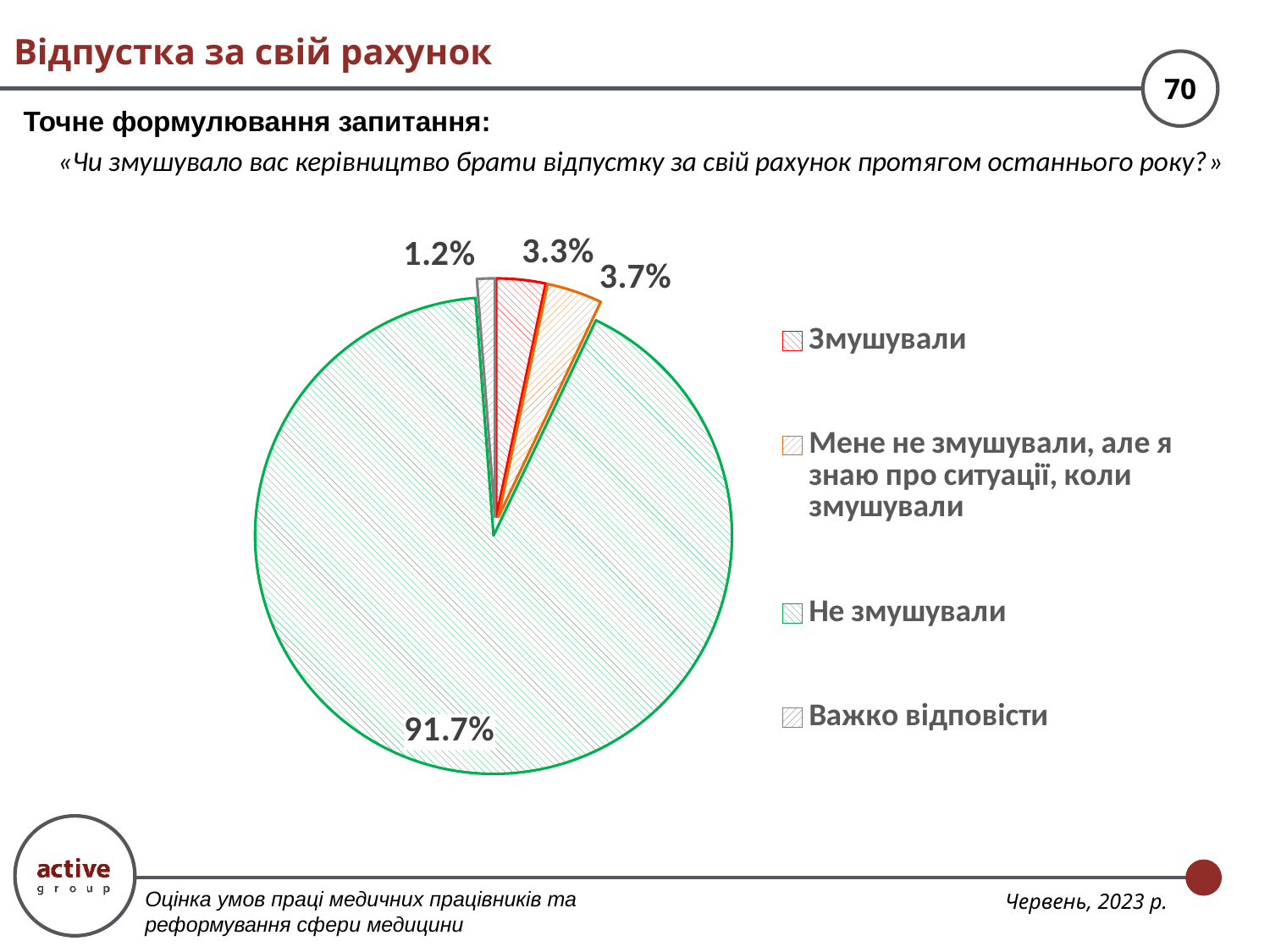
How many entries does the legend list? 4 What type of chart is shown on the slide? pie chart What percentage of respondents answered "Мене не змушували, але я знаю про ситуації, коли змушували"? 3.7% Which answer option has the largest share of the pie? Не змушували Which answer option has the smallest share of the pie? Важко відповісти What is the difference in percentage points between "Не змушували" and "Змушували"? 88.4 What colour is the slice for "Не змушували"? green What percentage of respondents answered "Змушували"? 3.3% Which is larger: the share for "Змушували" or the share for "Важко відповісти"? Змушували How many slices does the pie chart have? 4 What percentage of respondents answered "Не змушували"? 91.7% What percentage of respondents answered "Важко відповісти"? 1.2%